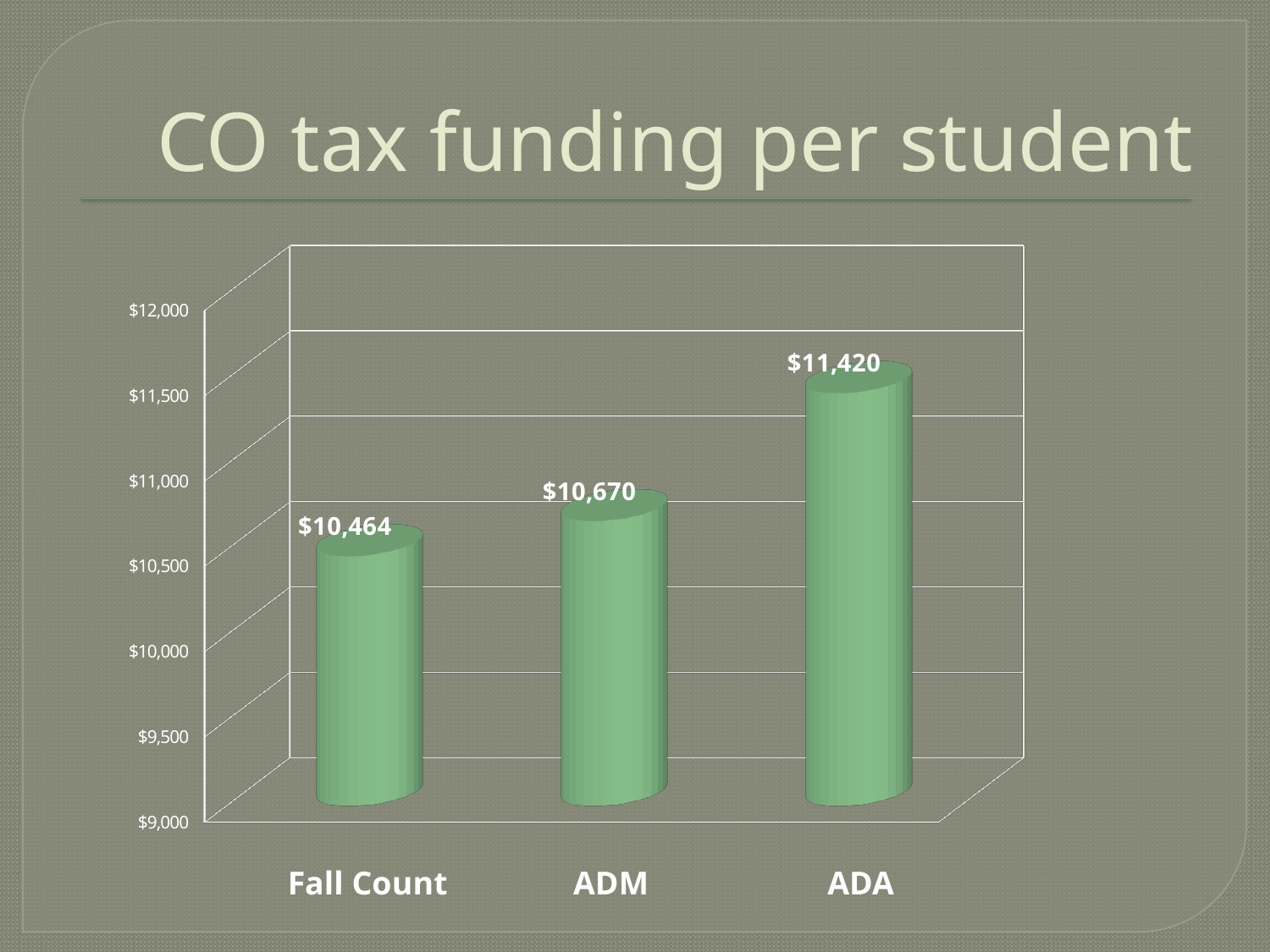
Do the values rise or fall from Fall Count to ADA along the x axis? rise Which is larger, the value for ADM or the value for ADA? ADA What is the CO tax funding per student for Fall Count? $10,464 Is the value for ADA greater or less than $11,000? greater Which category has the highest funding per student? ADA What kind of chart is shown on the slide? bar chart Which category has the lowest funding per student? Fall Count What is the CO tax funding per student for ADA? $11,420 What is the difference between the ADM and Fall Count values? $206 How many categories are shown on the x axis? 3 What is the difference between the ADA and Fall Count values? $956 What is the CO tax funding per student for ADM? $10,670